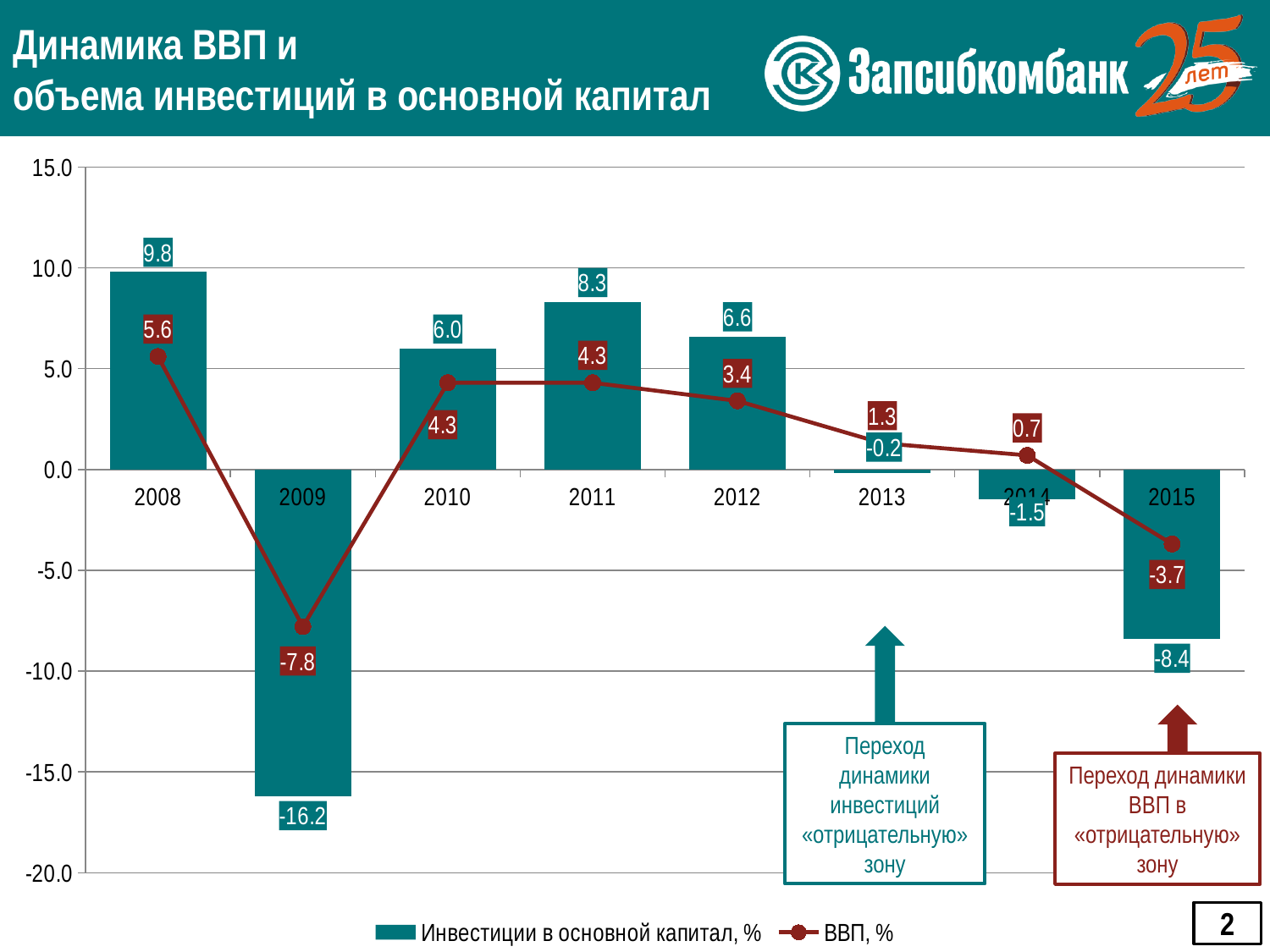
Which series is drawn as a line with markers? ВВП, % What is the value of Инвестиции в основной капитал, % for 2015? -8.4 Which is larger: the ВВП, % value for 2012 or for 2014? 2012 How many years are shown on the x axis? 8 Which year has the lowest value for Инвестиции в основной капитал, %? 2009 What is the value of Инвестиции в основной капитал, % for 2008? 9.8 How many series does the legend list? 2 What is the value of ВВП, % for 2013? 1.3 What is the value of ВВП, % for 2009? -7.8 Does the ВВП, % line rise or fall from 2012 to 2015? fall Which year has the highest value for ВВП, %? 2008 What is the difference between the Инвестиции в основной капитал, % values for 2011 and 2012? 1.7